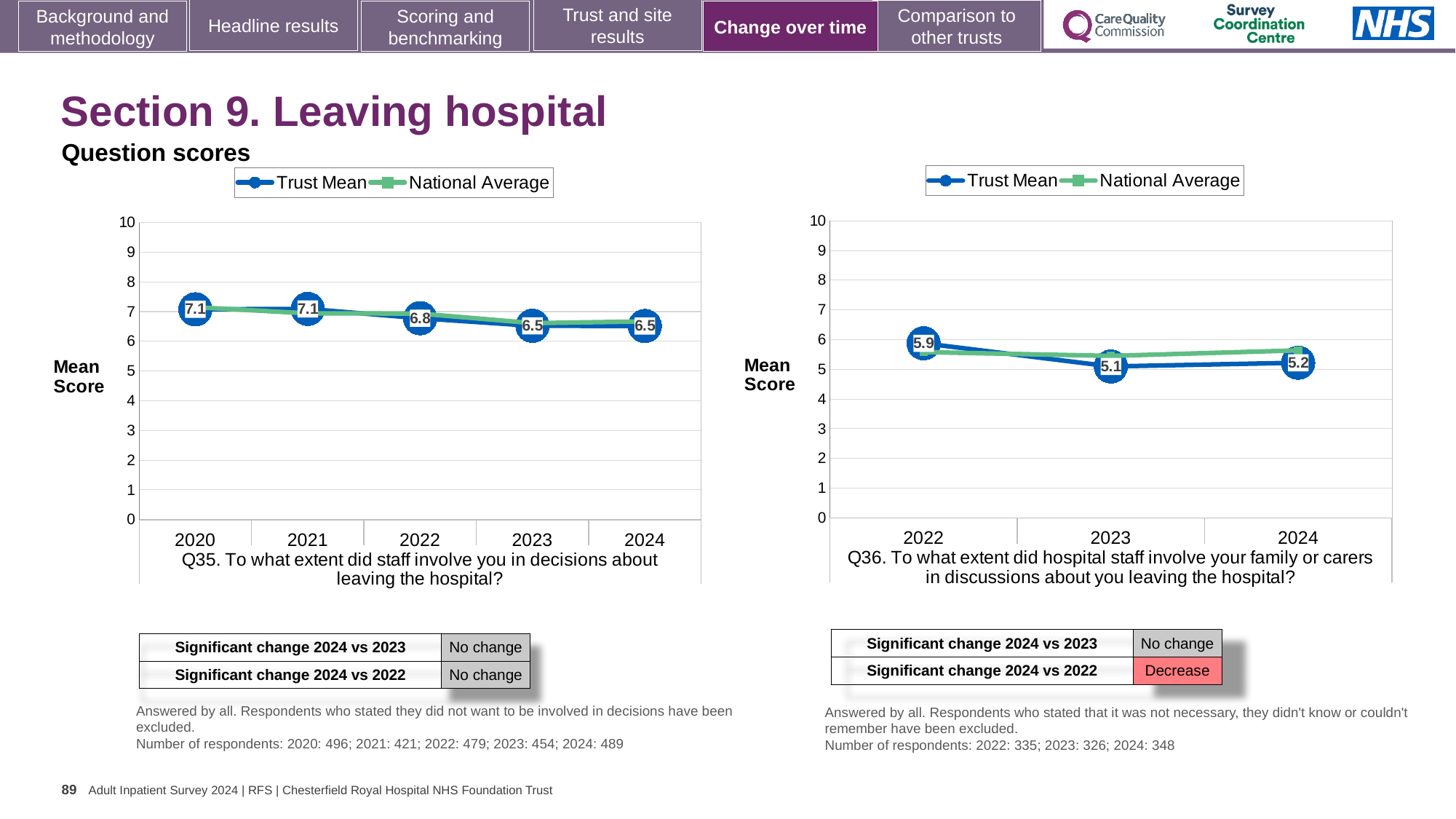
In the Q36 chart (right), which year has the lowest Trust Mean score? 2023 In the Q35 chart (left), is the Trust Mean score for 2021 higher or lower than for 2023? higher In the Q36 chart (right), what is the Trust Mean score for 2023? 5.1 In the Q35 chart (left), what is the difference between the Trust Mean score in 2020 and in 2024? 0.6 How many years are plotted on the x axis of the Q35 chart (left)? 5 In the Q36 chart (right), which year has the highest Trust Mean score? 2022 In the Q36 chart (right), what is the Trust Mean score for 2022? 5.9 What kind of chart is the Q35 chart (left)? line chart In the Q35 chart (left), what is the Trust Mean score for 2022? 6.8 In the Q35 chart (left), what is the Trust Mean score for 2024? 6.5 How many series does the legend of the Q36 chart (right) list? 2 In the Q36 chart (right), what is the difference between the Trust Mean score in 2022 and in 2024? 0.7